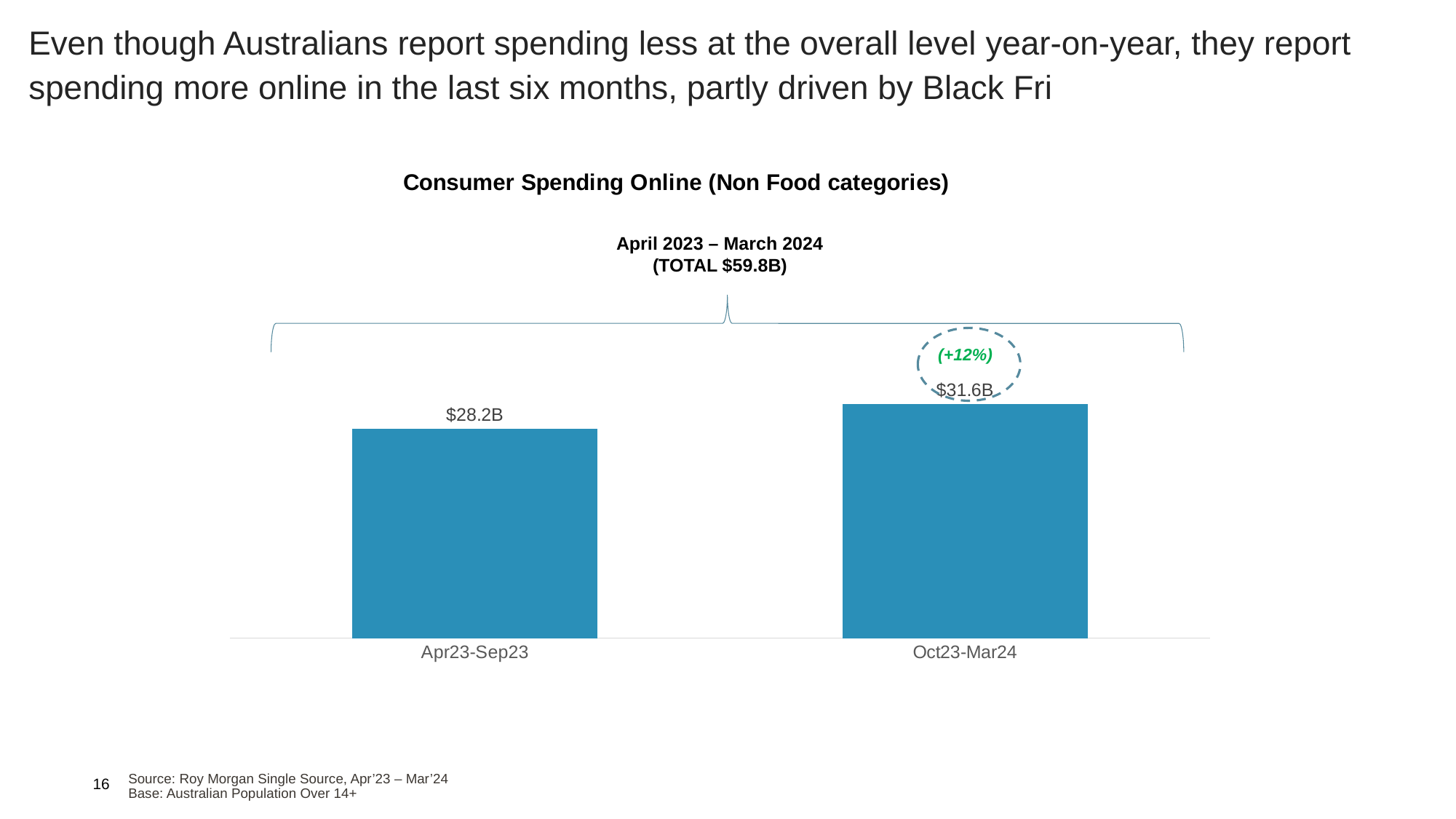
What percentage change is shown in the dashed circle above the Oct23-Mar24 bar? +12% What is the difference between the Oct23-Mar24 and Apr23-Sep23 values? $3.4B Do the values rise or fall from Apr23-Sep23 to Oct23-Mar24? rise How many periods are shown on the chart? 2 What is the value for Apr23-Sep23? $28.2B What is the total for April 2023 – March 2024 shown above the bracket? $59.8B Which period has the lower consumer spending online? Apr23-Sep23 Which period has the higher consumer spending online? Oct23-Mar24 What is the title of the chart? Consumer Spending Online (Non Food categories) What is the value for Oct23-Mar24? $31.6B Is the value for Oct23-Mar24 larger or smaller than the value for Apr23-Sep23? larger What kind of chart is shown? bar chart